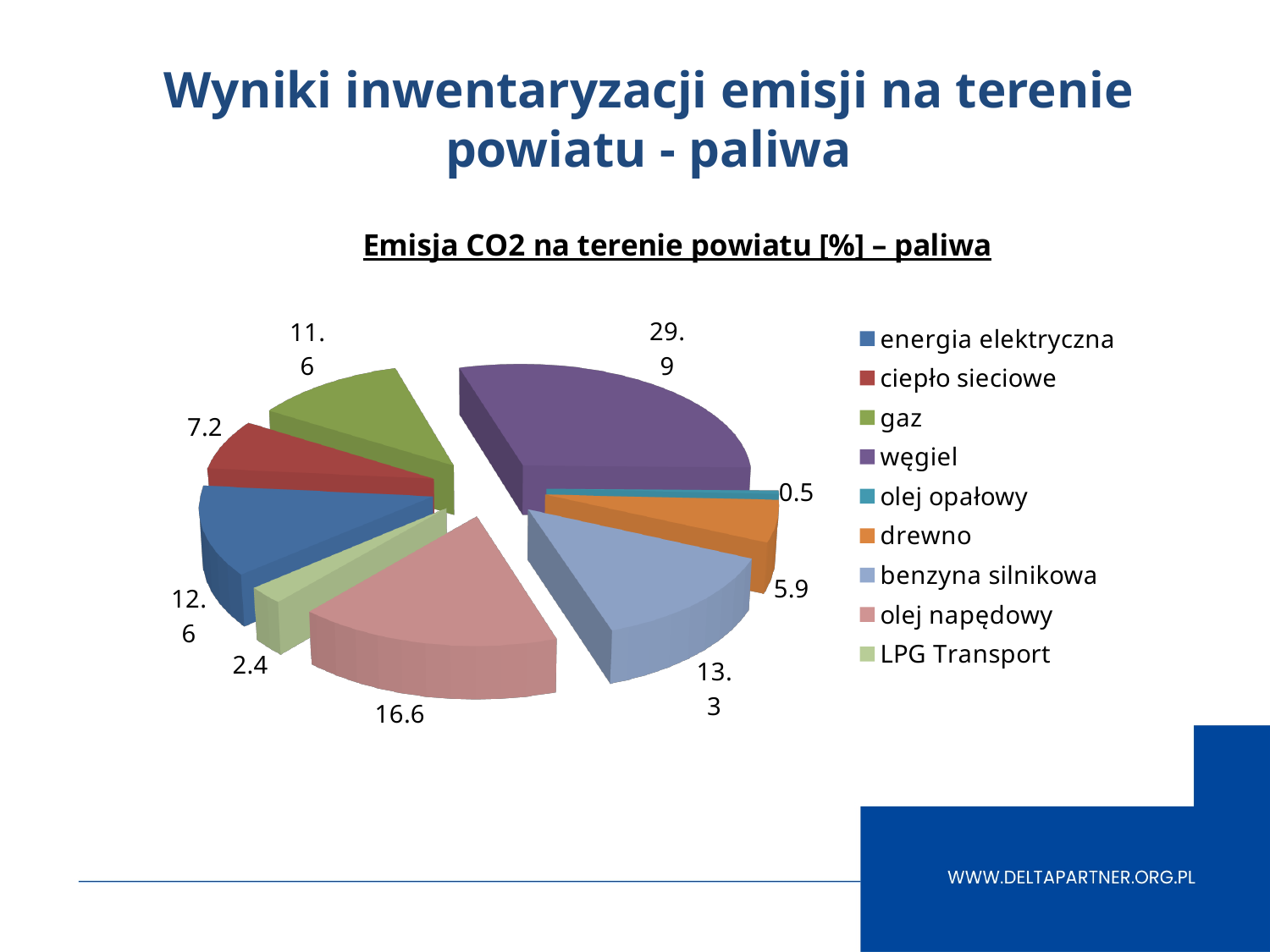
What is the value for LPG Transport? 2.4 What is the title of the chart? Emisja CO2 na terenie powiatu [%] – paliwa Which category has the largest slice? węgiel What is the difference between the values for węgiel and olej napędowy? 13.3 What type of chart is shown on the slide? pie chart Which category has the smallest slice? olej opałowy What is the value for węgiel? 29.9 How many categories does the pie chart have? 9 Which is larger, the value for energia elektryczna or the value for gaz? energia elektryczna What is the value for benzyna silnikowa? 13.3 What is the value for olej napędowy? 16.6 What share of the pie does drewno represent? 5.9%